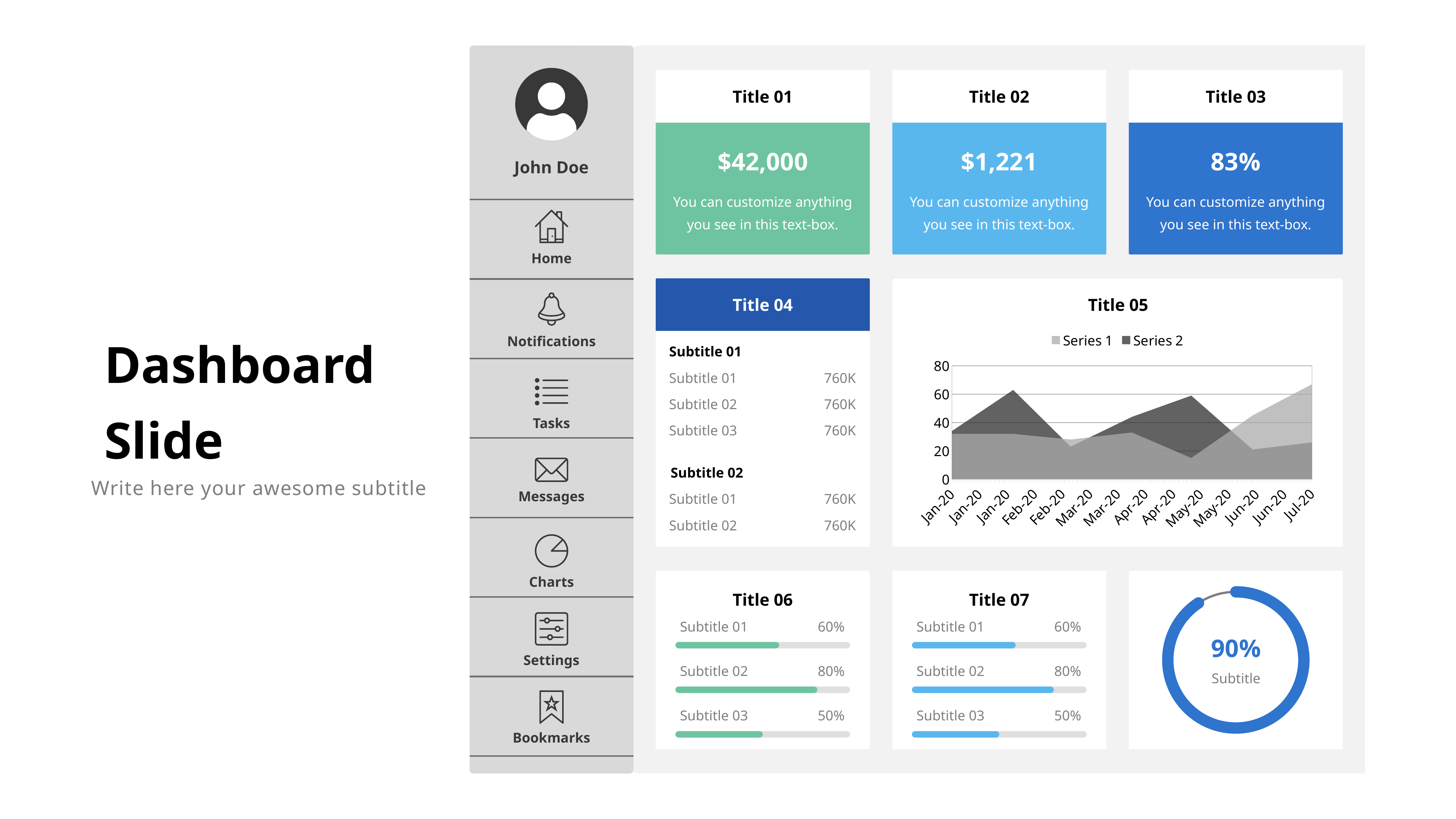
In the Title 07 progress bars, which subtitle has the lowest value? Subtitle 03 What is the highest value shown on the y axis of the Title 05 chart? 80 What are the legend entries of the Title 05 chart? Series 1, Series 2 How many points are plotted along the x axis of the Title 05 chart? 7 In the Title 06 progress bars, what is the value for Subtitle 02? 80% In the Title 05 chart, is the value of Series 1 at the first Jan-20 point greater or less than 40? less In the Title 05 chart, which series has the larger value at Jul-20, Series 1 or Series 2? Series 1 What kind of chart is shown under Title 05? area chart How many series does the legend of the Title 05 chart list? 2 In the Title 05 chart, is the value of Series 1 at Jul-20 greater or less than 40? greater